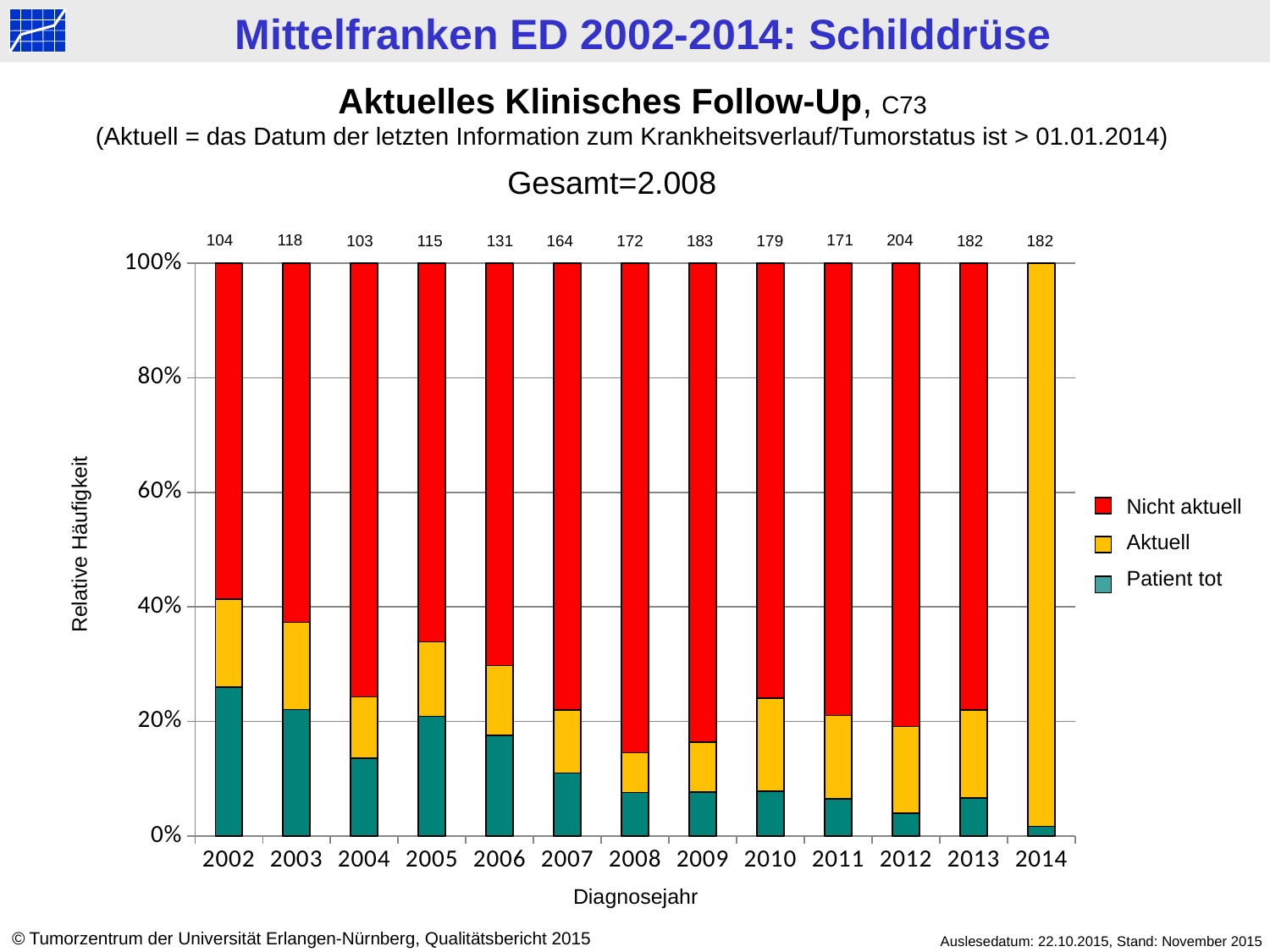
What is the number printed above the bar for 2002? 104 Is the 'Aktuell' share for 2014 greater or less than 80%? greater Which diagnosis year has the lowest number printed above its bar? 2004 What is the difference between the numbers printed above the bars for 2012 and 2004? 101 Which diagnosis year has the highest number printed above its bar? 2012 What is the number printed above the bar for 2012? 204 What is the title of the x axis? Diagnosejahr What kind of chart is shown on the slide? Stacked bar chart How many series does the legend list? 3 Is the 'Patient tot' share for 2002 greater or less than 20%? greater Which year has the larger number printed above its bar, 2009 or 2010? 2009 How many diagnosis years are shown on the x axis? 13